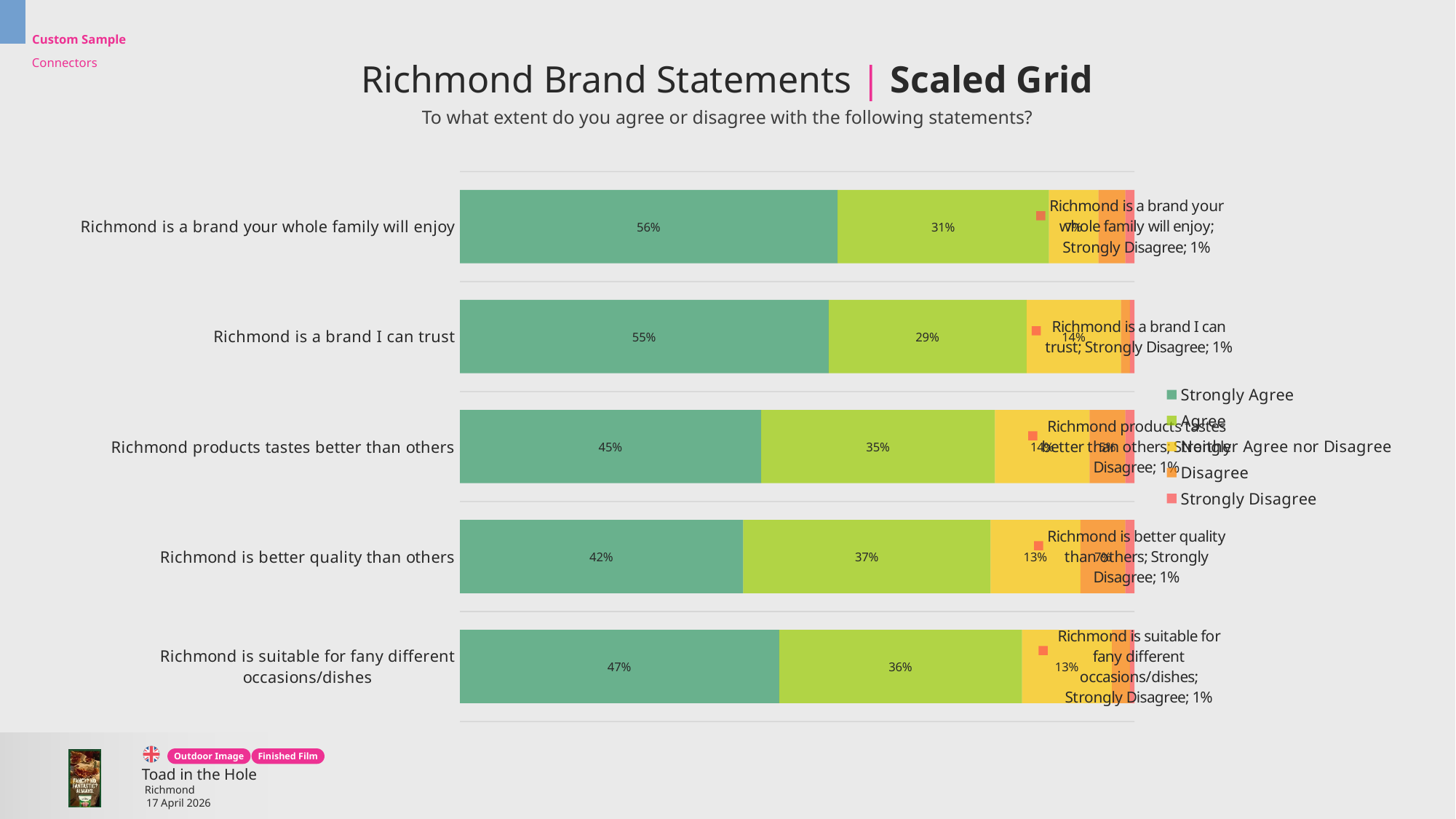
For 'Richmond is a brand I can trust', what is the difference between the Strongly Agree and Agree percentages? 26 percentage points What is the Strongly Disagree value for 'Richmond is better quality than others'? 1% Which has a larger Strongly Agree value: 'Richmond is a brand your whole family will enjoy' or 'Richmond is suitable for fany different occasions/dishes'? Richmond is a brand your whole family will enjoy Which colour represents Strongly Agree in the legend? Green What percentage of respondents Strongly Agree that Richmond is a brand your whole family will enjoy? 56% What type of chart is shown on the slide? Stacked bar chart What is the Agree value for the statement 'Richmond is better quality than others'? 37% Which statement has the highest Strongly Agree percentage? Richmond is a brand your whole family will enjoy How many statements are shown in the chart? 5 How many series does the legend list? 5 Which statement has the lowest Strongly Agree percentage? Richmond is better quality than others What is the Neither Agree nor Disagree value for 'Richmond is a brand I can trust'? 14%